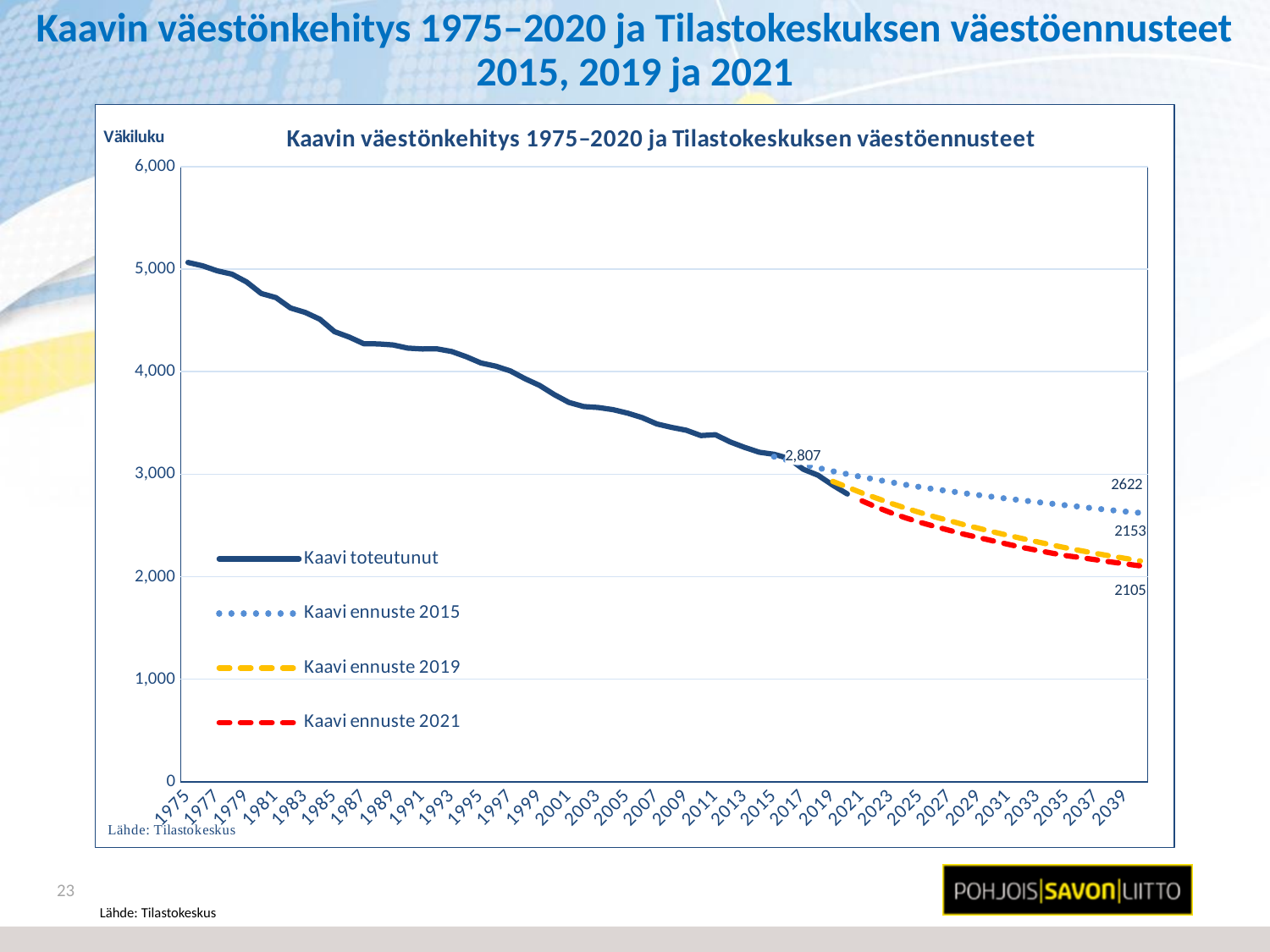
What label is shown on the vertical axis of the chart? Väkiluku Is the value of Kaavi toteutunut in 2005 greater or less than 4,000? less Does the Kaavi toteutunut series rise or fall from 1975 to 2020? Fall Which forecast series ends at a higher value, Kaavi ennuste 2015 or Kaavi ennuste 2021? Kaavi ennuste 2015 How many series does the chart legend list? 4 What is the difference between the final labelled values of Kaavi ennuste 2019 and Kaavi ennuste 2021? 48 What kind of chart is shown on the slide? Line chart What is the difference between the final labelled values of Kaavi ennuste 2015 and Kaavi ennuste 2021? 517 What is the final labelled value of the Kaavi ennuste 2019 series? 2153 What is the final labelled value of the Kaavi ennuste 2021 series? 2105 What is the final labelled value of the Kaavi ennuste 2015 series? 2622 Which of the three forecast series ends at the lowest value? Kaavi ennuste 2021